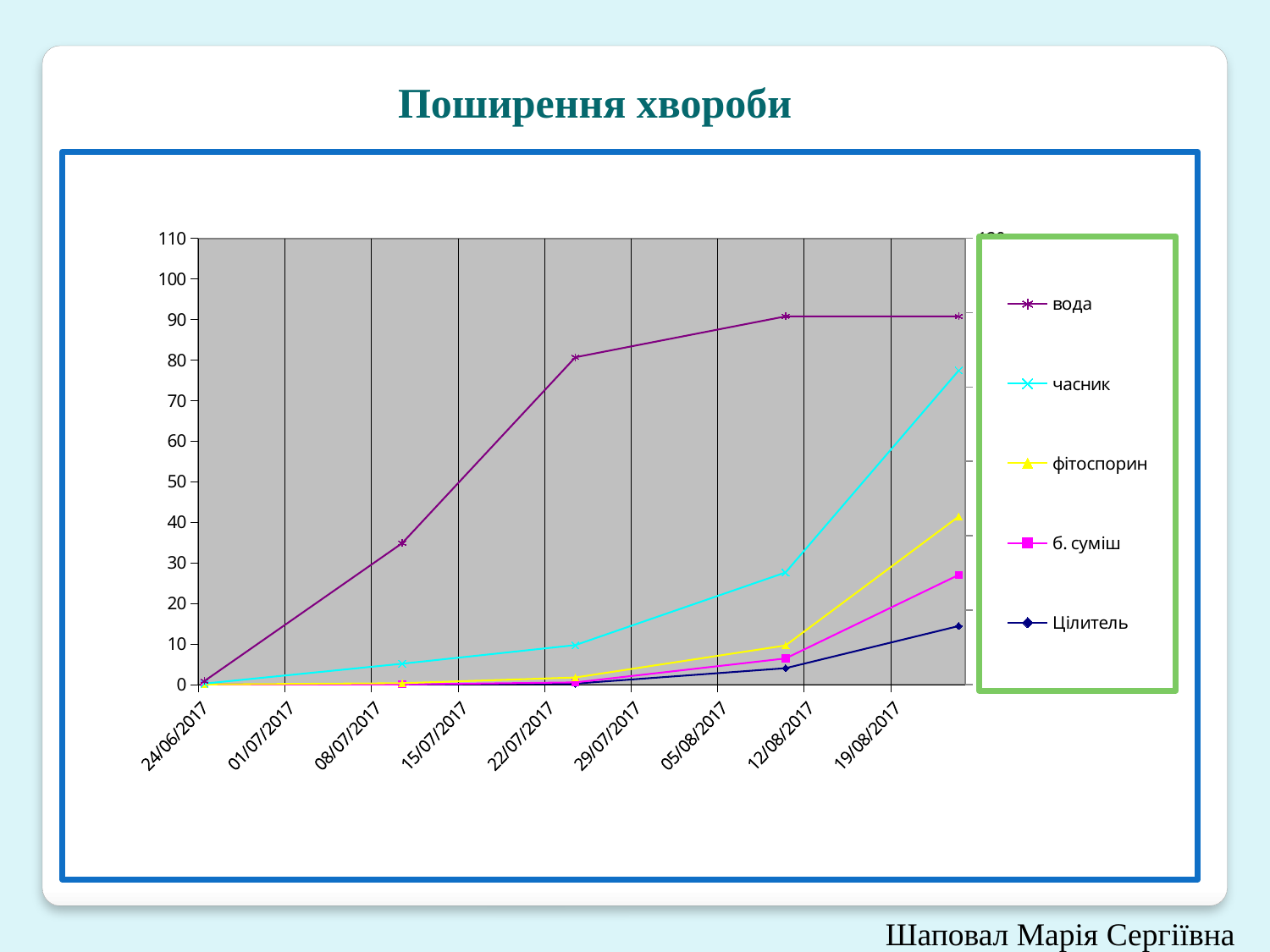
Is the final value for вода greater or less than 80? greater What is the title of the chart? Поширення хвороби Is the final value for часник greater or less than 70? greater Which series is highest at the final data point? вода How many date labels are shown on the x axis? 9 At the final data point, which is larger: часник or фітоспорин? часник Is the final value for б. суміш greater or less than 30? less How many series does the legend list? 5 Which series is lowest at the final data point? Цілитель What kind of chart is shown on the slide? line chart Do the values for часник rise or fall over time along the x axis? rise